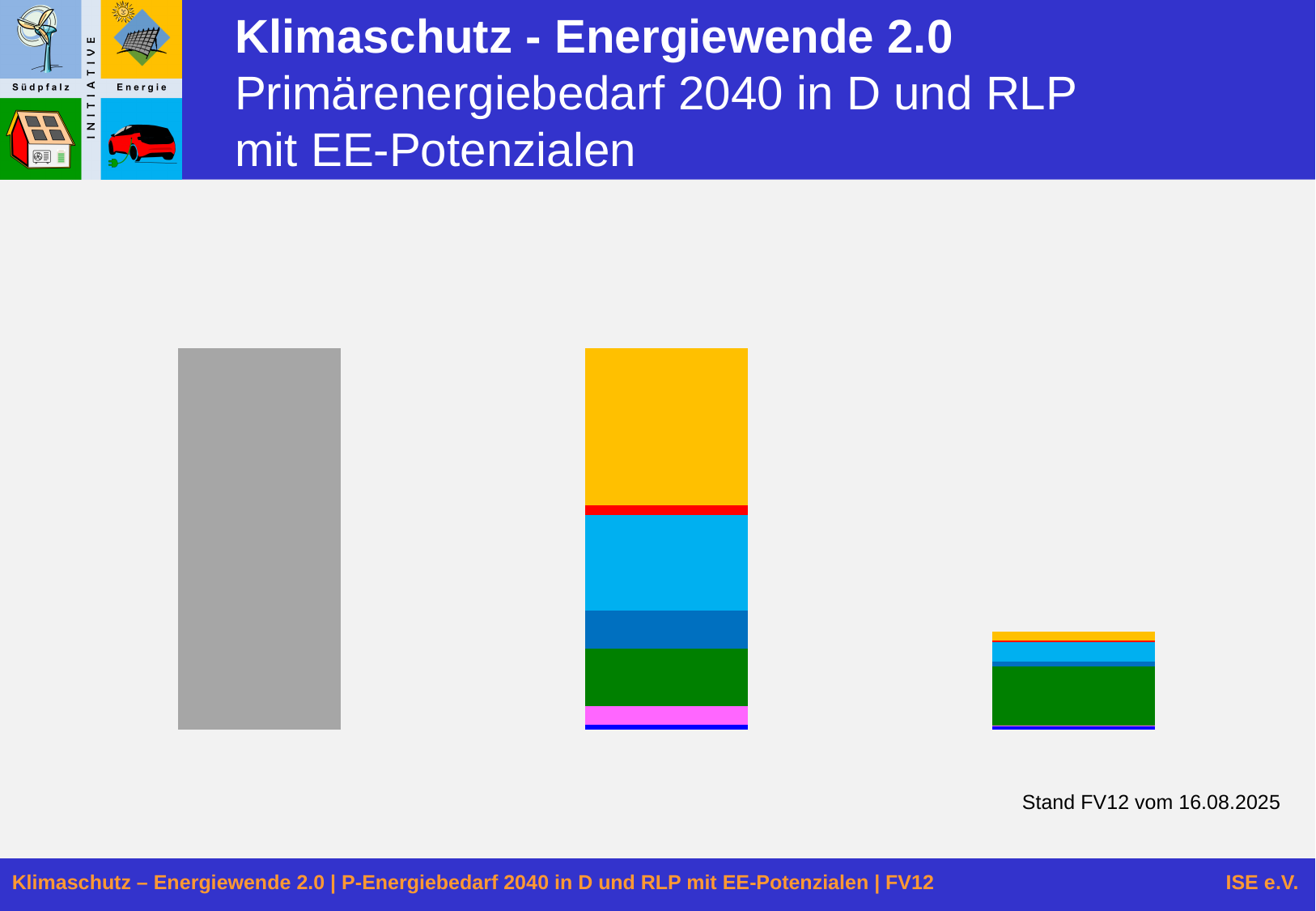
What colour is the left bar? gray What kind of chart is shown on the slide? bar chart Which bar is the shortest: the left, middle or right one? right Is the middle bar taller or shorter than the right bar? taller Is the left bar taller or shorter than the right bar? taller How many bars are plotted in the chart? 3 Which colour segment is the largest in the right stacked bar? green Which colour segment is the largest in the middle stacked bar? yellow/orange